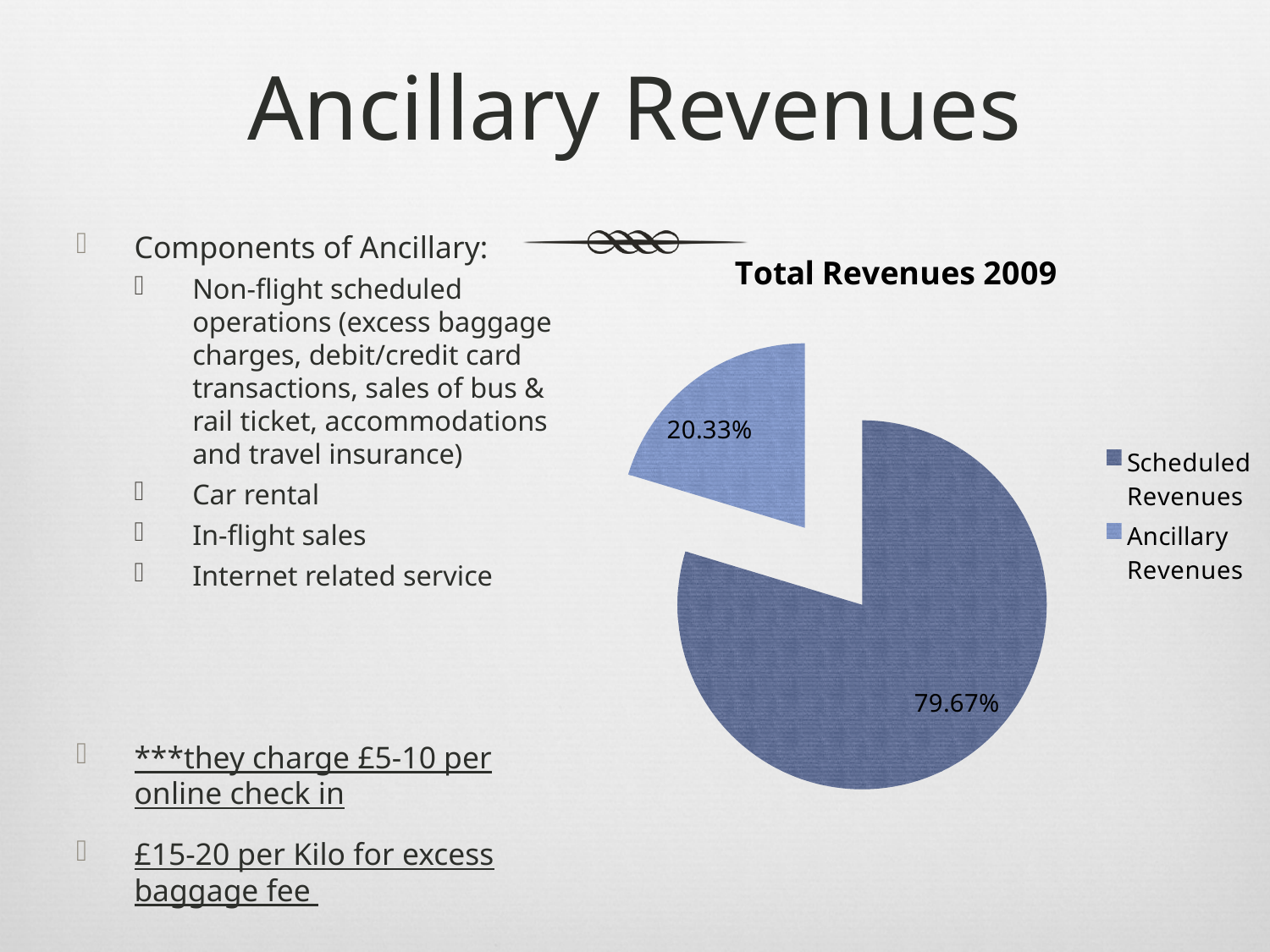
How many slices does the pie chart have? 2 Which slice of the pie is the smallest? Ancillary Revenues What is the difference in percentage points between Scheduled Revenues and Ancillary Revenues? 59.34 What share of the pie is Scheduled Revenues? 79.67% What share of the pie is Ancillary Revenues? 20.33% How many entries does the legend list? 2 Which slice of the pie is the largest? Scheduled Revenues Which is larger, Scheduled Revenues or Ancillary Revenues? Scheduled Revenues What is the title of the chart? Total Revenues 2009 What kind of chart is shown on the slide? pie chart Which legend entry is shown in the lighter blue colour? Ancillary Revenues